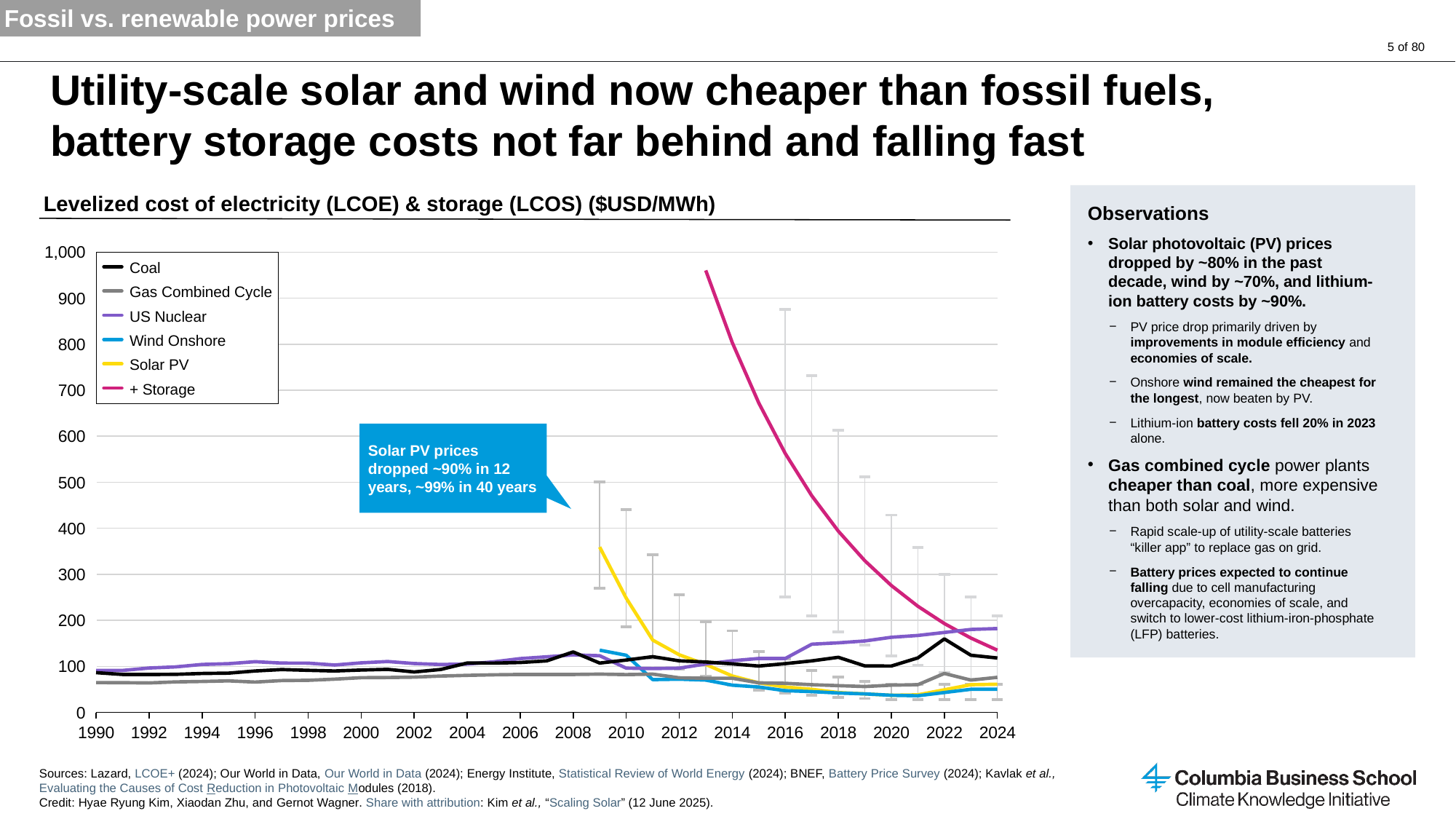
Does the + Storage line rise or fall from 2013 to 2024? Fall What is the title of the chart? Levelized cost of electricity (LCOE) & storage (LCOS) ($USD/MWh) How many series does the chart legend list? 6 What kind of chart is shown on the slide? Line chart Which series has the highest value in 2024? US Nuclear Is the value for + Storage in 2013 greater or less than 900? greater Is the value for Solar PV in 2009 greater or less than 300? greater In 2024, which is larger, the value for US Nuclear or the value for Gas Combined Cycle? US Nuclear Does the US Nuclear line rise or fall from 1990 to 2024? Rise Does the Solar PV line rise or fall from 2009 to 2024? Fall Which series is drawn in yellow in the chart? Solar PV Is the value for Gas Combined Cycle in 2024 greater or less than 100? less